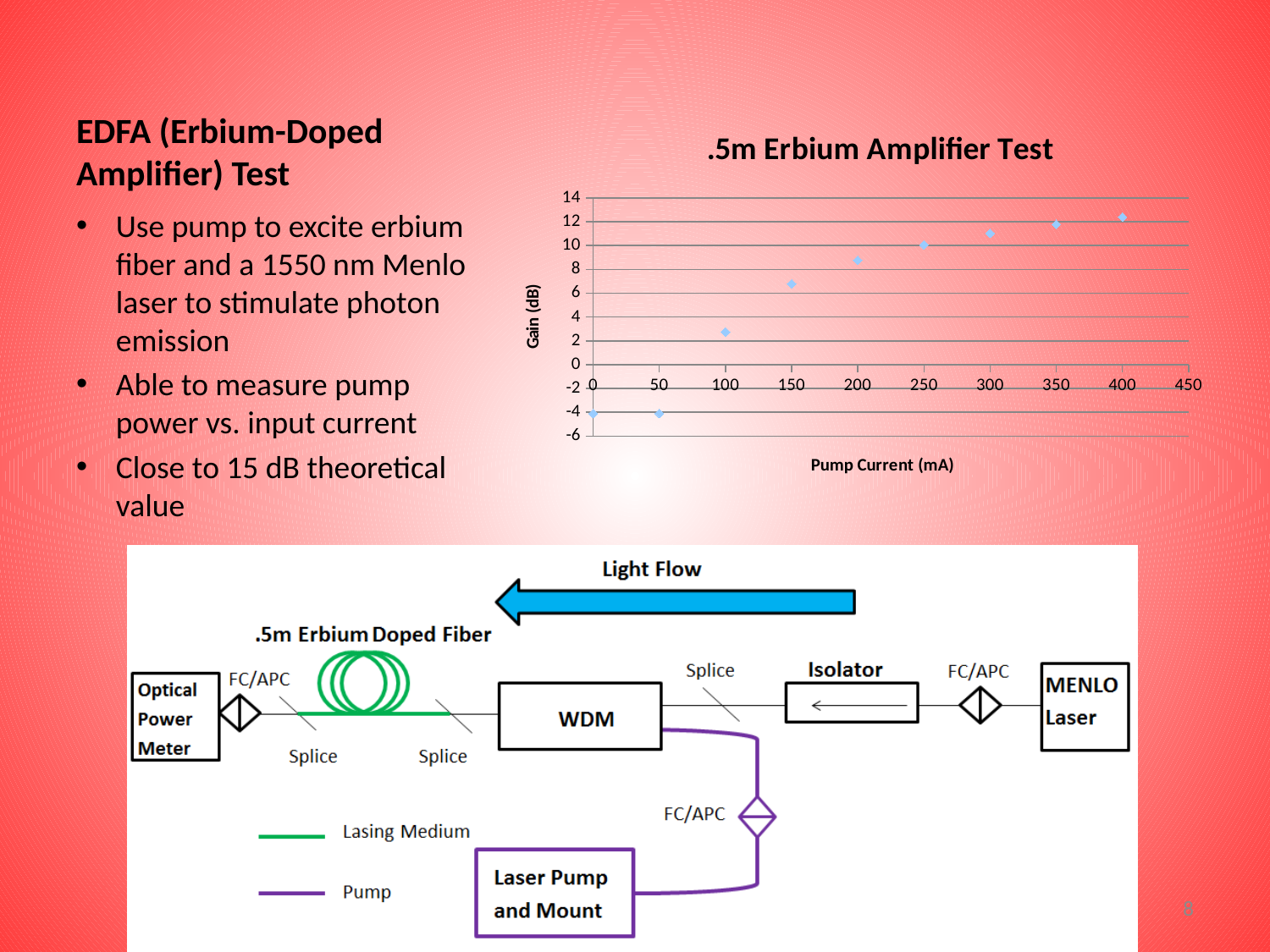
Is the gain at a pump current of 200 mA greater or less than 8 dB? greater Is the gain at a pump current of 100 mA greater or less than 4 dB? less Is the gain at a pump current of 400 mA greater or less than 10 dB? greater How many data points are plotted in the chart? 9 What kind of chart is shown on the slide? scatter chart Which has the larger gain: a pump current of 100 mA or 300 mA? 300 mA At which pump current is the gain highest? 400 Does the gain rise or fall as pump current increases along the x axis? rise What is the label of the y axis of the chart? Gain (dB) What is the title of the chart? .5m Erbium Amplifier Test